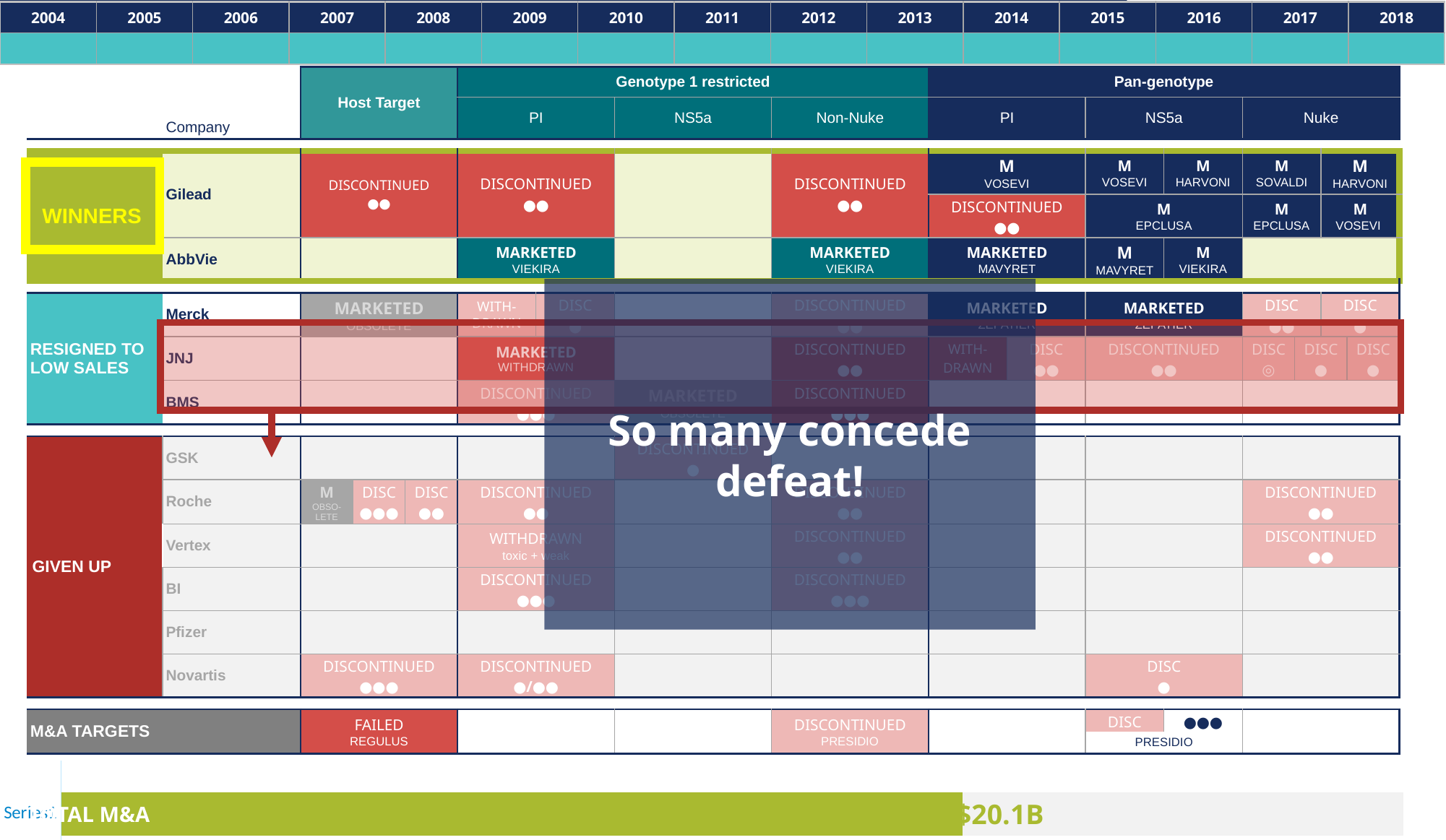
What kind of chart is shown at the bottom of the slide? bar chart In the bar chart at the bottom of the slide, what text label is overlaid on the bar? TOTAL M&A In the bar chart at the bottom of the slide, is the bar drawn horizontally or vertically? horizontally In the bar chart at the bottom of the slide, what is the series label shown at the left of the bar? Series1 In the bar chart at the bottom of the slide, what value is printed on the bar? $20.1B